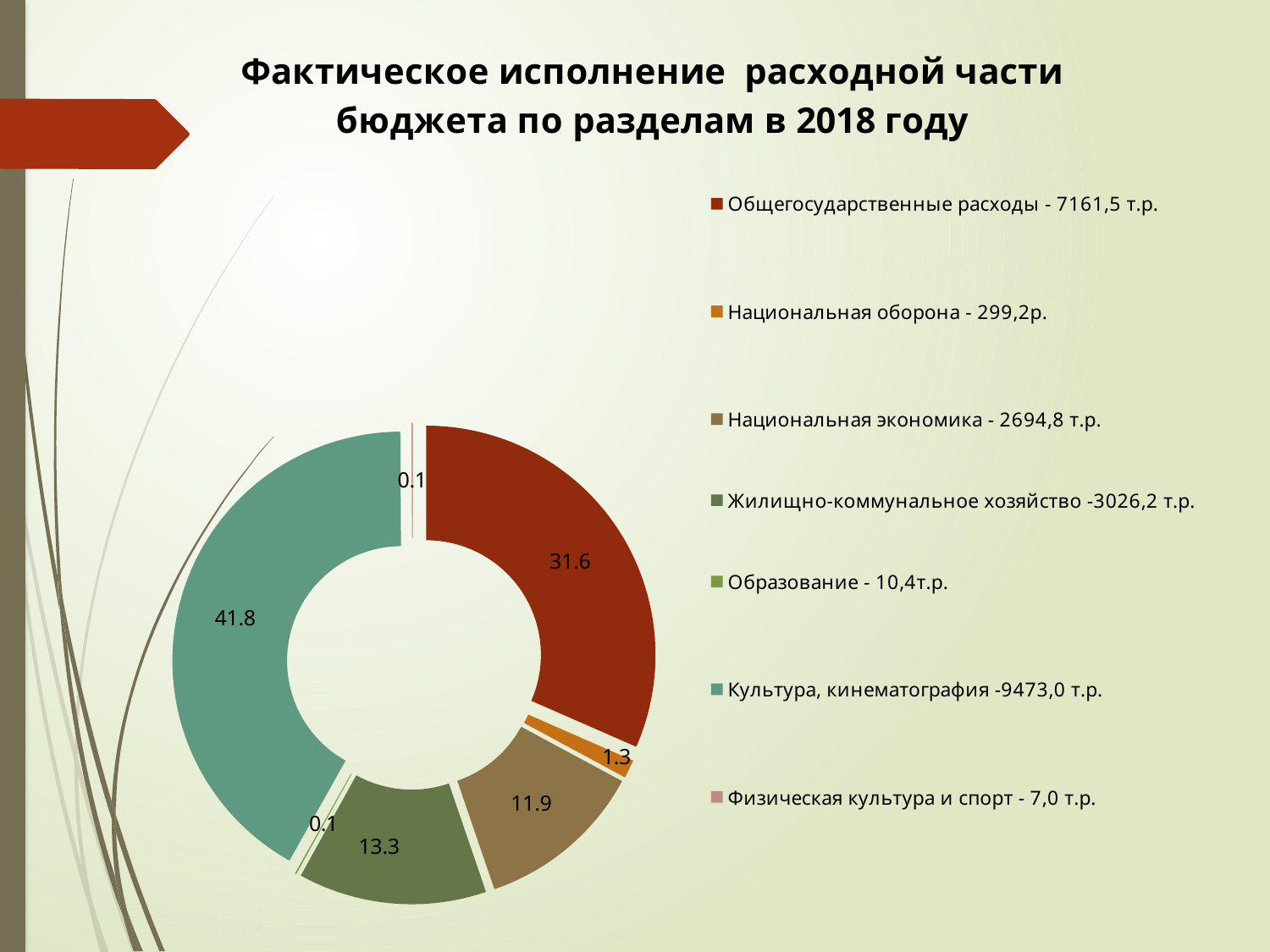
What value is shown for the slice 'Культура, кинематография'? 41.8 What type of chart is shown on the slide? Doughnut (pie) chart What amount does the legend give for 'Культура, кинематография'? 9473,0 т.р. What value is shown for the slice 'Национальная экономика'? 11.9 Which is larger: the slice for 'Жилищно-коммунальное хозяйство' or the slice for 'Национальная экономика'? Жилищно-коммунальное хозяйство How many categories does the legend list? 7 What is the difference between the values for 'Культура, кинематография' and 'Общегосударственные расходы'? 10.2 What value is shown for the slice 'Жилищно-коммунальное хозяйство'? 13.3 Which category has the largest slice? Культура, кинематография What value is shown for the slice 'Общегосударственные расходы'? 31.6 What amount does the legend give for 'Образование'? 10,4т.р. What value is shown for the slice 'Национальная оборона'? 1.3